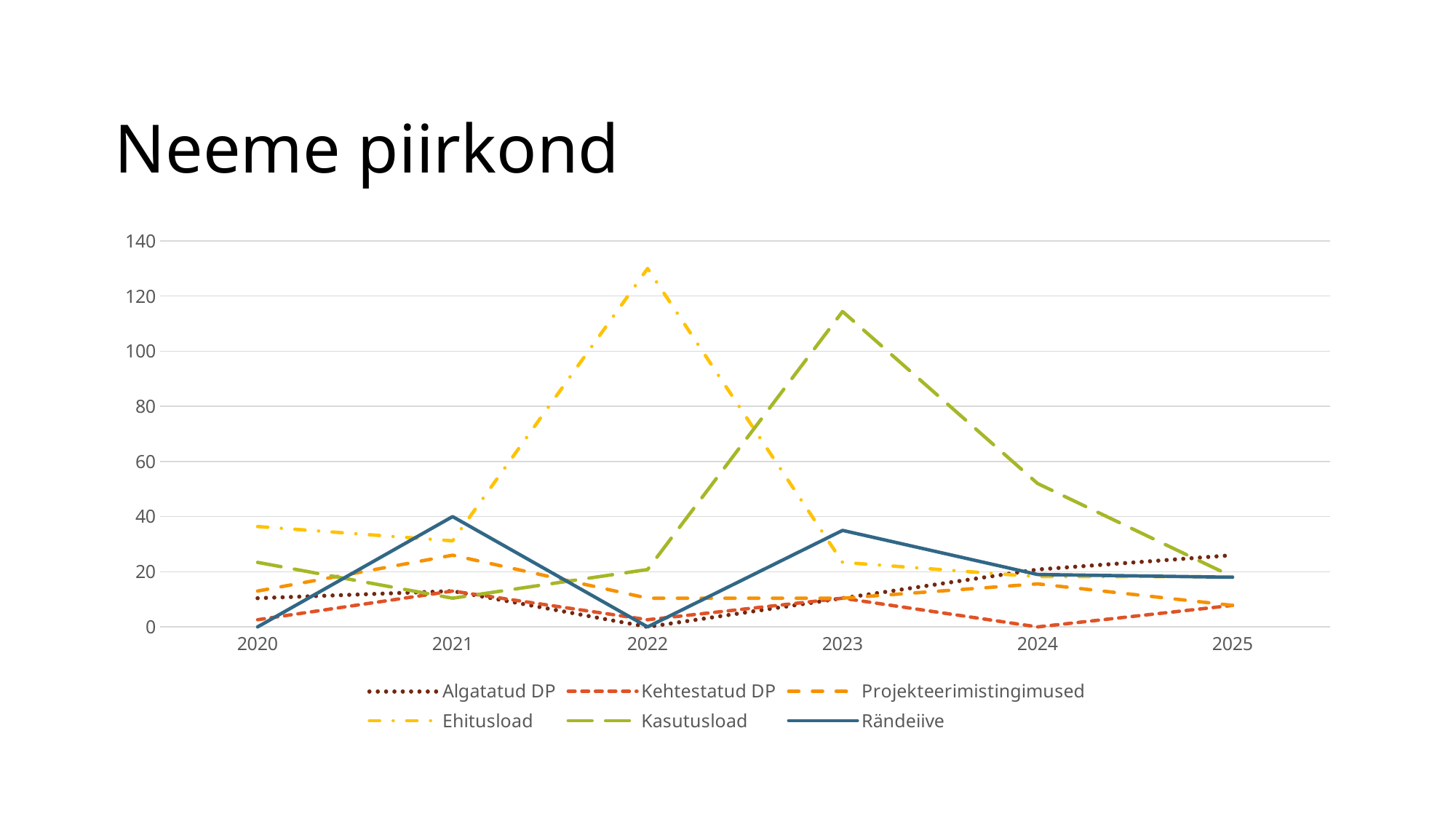
How many series does the legend list? 6 In which year does Kasutusload reach its highest value? 2023 What is the title of the slide? Neeme piirkond Is the value for Kasutusload in 2023 greater or less than 100? greater Is the value for Ehitusload in 2022 greater or less than 120? greater Does Kasutusload rise or fall from 2023 to 2025? fall How many years are shown on the x axis? 6 Which is larger: Ehitusload in 2022 or Kasutusload in 2023? Ehitusload in 2022 Is the value for Kasutusload in 2024 greater or less than 60? less In which year does Ehitusload reach its highest value? 2022 What kind of chart is shown on the slide? line chart What is the value for Rändeiive in 2020? 0